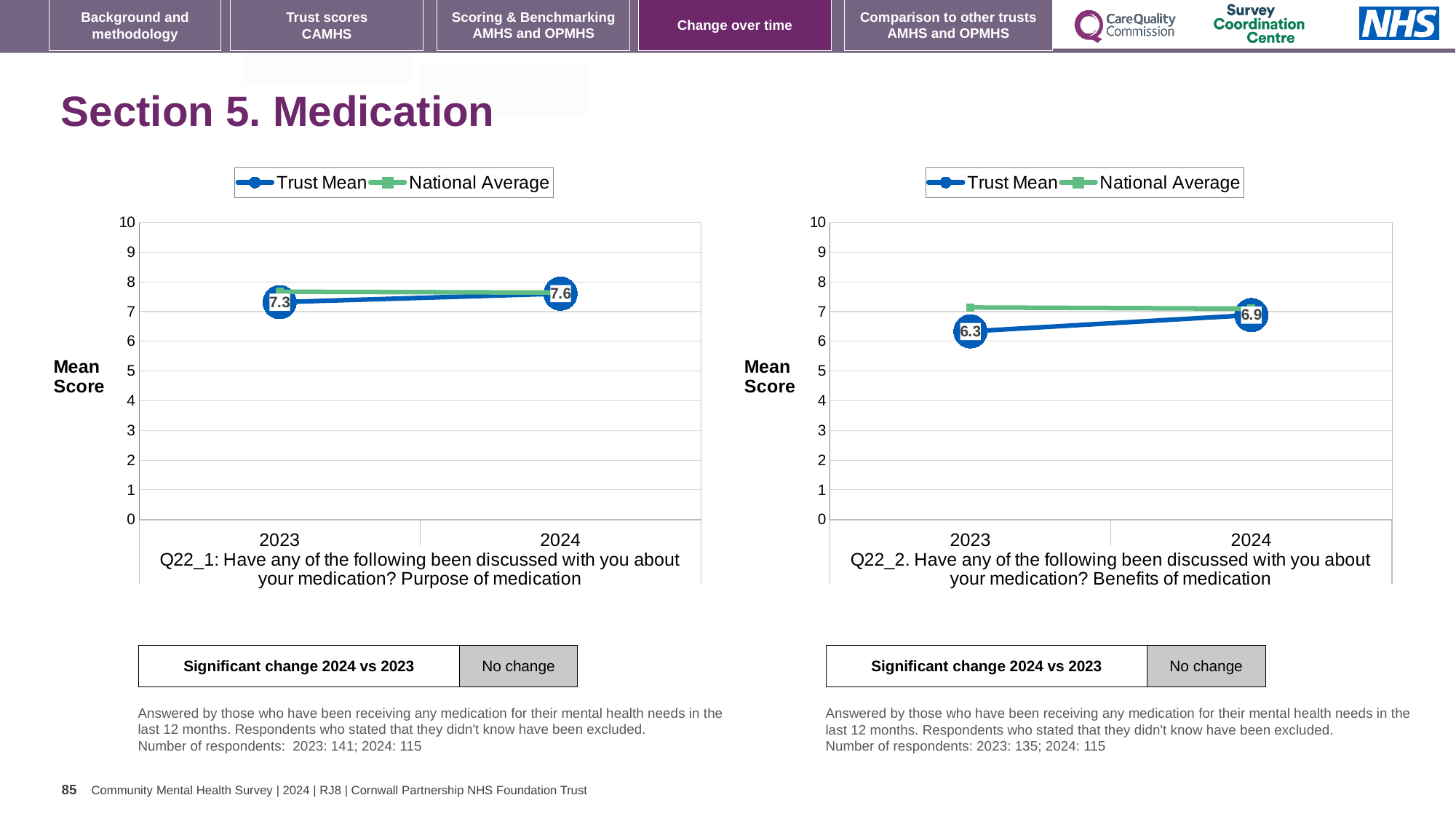
In the right chart (Q22_2: Benefits of medication), which is larger: the Trust Mean for 2023 or the Trust Mean for 2024? 2024 How many series does the legend of the right chart (Q22_2: Benefits of medication) list? 2 In the right chart (Q22_2: Benefits of medication), what is the Trust Mean score for 2023? 6.3 In the right chart (Q22_2: Benefits of medication), by how much did the Trust Mean change from 2023 to 2024? 0.6 In the right chart (Q22_2: Benefits of medication), is the National Average value for 2023 greater or less than 6? greater What kind of chart is the left chart (Q22_1: Purpose of medication)? line chart In the left chart (Q22_1: Purpose of medication), what is the Trust Mean score for 2024? 7.6 In the right chart (Q22_2: Benefits of medication), what is the Trust Mean score for 2024? 6.9 How many years are plotted on the x axis of the left chart (Q22_1: Purpose of medication)? 2 In the left chart (Q22_1: Purpose of medication), what is the Trust Mean score for 2023? 7.3 In the right chart (Q22_2: Benefits of medication), does the Trust Mean rise or fall from 2023 to 2024? rise In the left chart (Q22_1: Purpose of medication), by how much did the Trust Mean change from 2023 to 2024? 0.3